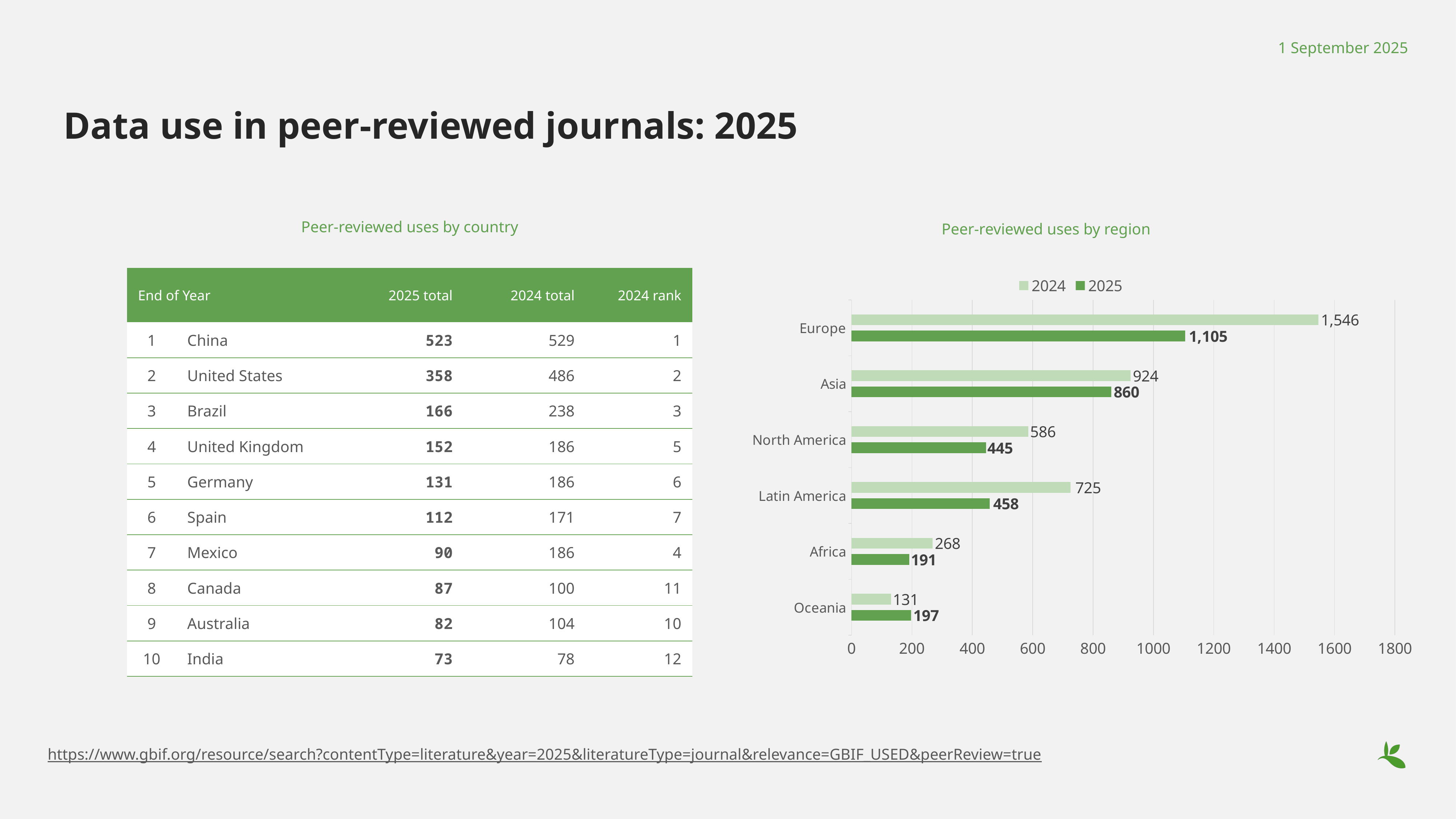
In the 'Peer-reviewed uses by region' chart, which region has the larger 2025 value: North America or Latin America? Latin America How many series does the legend of the 'Peer-reviewed uses by region' chart list? 2 What kind of chart is 'Peer-reviewed uses by region'? Bar chart In the 'Peer-reviewed uses by region' chart, what is the difference between the 2024 and 2025 values for Asia? 64 In the 'Peer-reviewed uses by region' chart, what is the 2024 value for Latin America? 725 In the 'Peer-reviewed uses by region' chart, what is the 2025 value for Oceania? 197 In the 'Peer-reviewed uses by region' chart, which region has the highest 2024 value? Europe How many regions are shown in the 'Peer-reviewed uses by region' chart? 6 In the 'Peer-reviewed uses by region' chart, what is the difference between the 2024 and 2025 values for Europe? 441 In the 'Peer-reviewed uses by region' chart, which is larger for Oceania: the 2024 value or the 2025 value? 2025 In the 'Peer-reviewed uses by region' chart, which region has the lowest 2025 value? Africa In the 'Peer-reviewed uses by region' chart, what is the 2025 value for Europe? 1,105